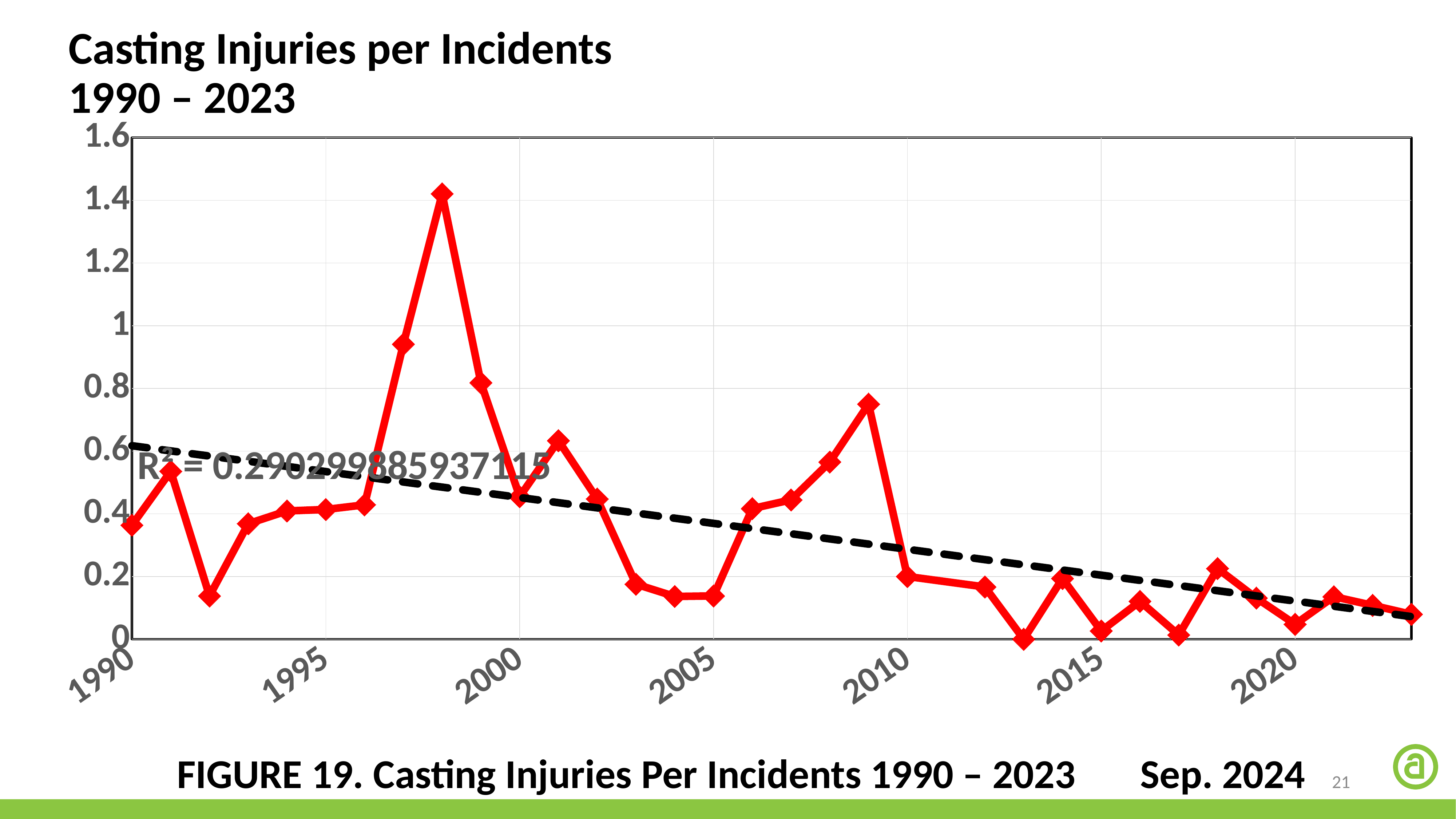
How many data points are plotted on the line? 33 What R² value is printed on the chart? R² = 0.290299885937115 Is the value for 2010 greater or less than 0.4? less Is the value for 1997 greater or less than 0.8? greater What kind of chart is shown on the slide? Line chart Which year has the highest casting injuries per incidents value? 1998 Is the value for 1998 greater or less than 1.2? greater According to the dashed trendline, do the values rise or fall from 1990 to 2023? Fall Which year has the larger value, 1997 or 1999? 1997 Which year has the larger value, 1998 or 2009? 1998